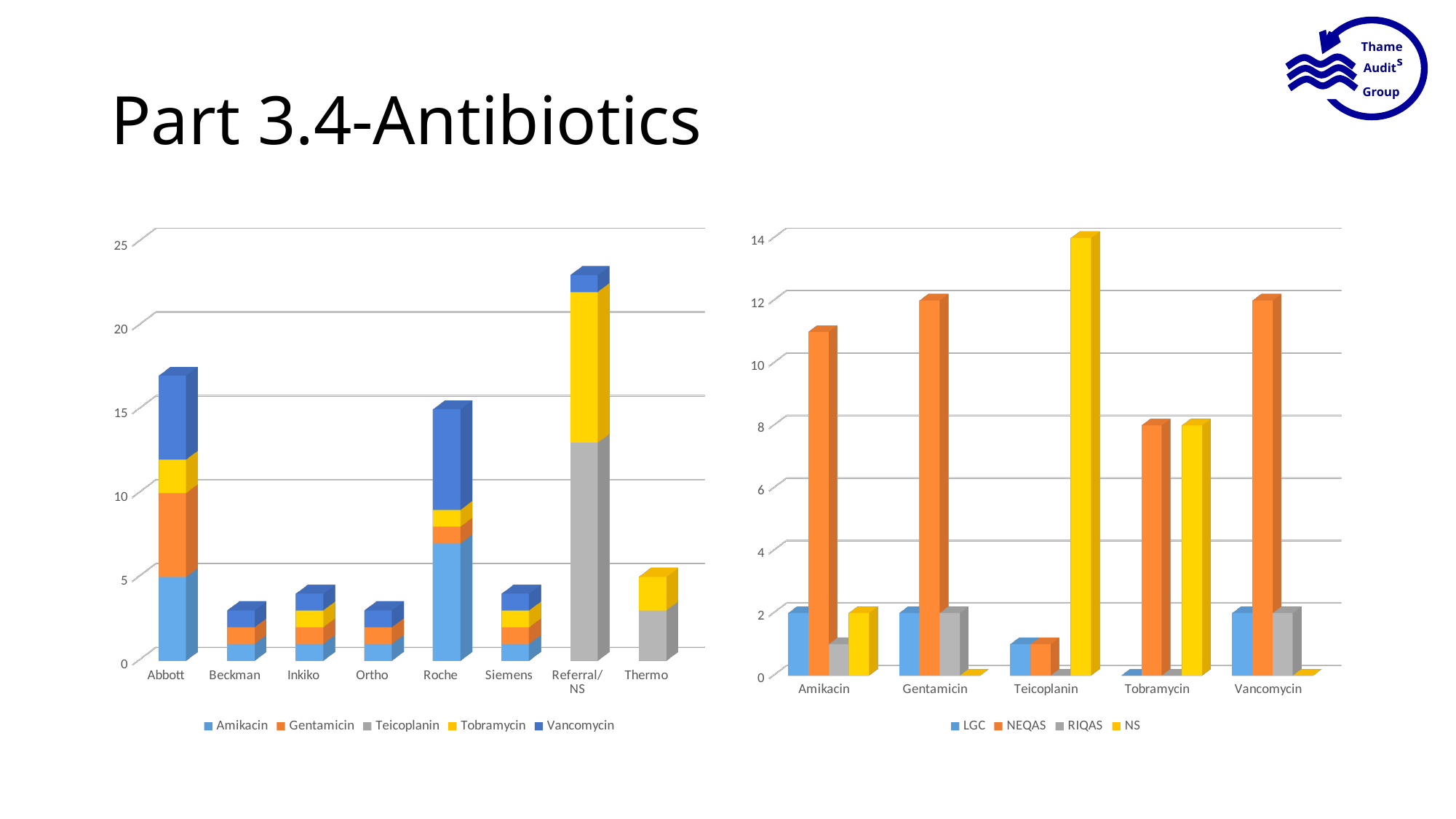
How many series does the legend of the left chart list? 5 In the right chart, is the NEQAS value for Amikacin greater or less than 10? greater How many series does the legend of the right chart list? 4 How many categories are shown on the x axis of the right chart? 5 In the right chart, which category has the highest NS bar? Teicoplanin In the right chart, what is the NEQAS value for Gentamicin? 12 In the right chart, what is the NS value for Teicoplanin? 14 In the right chart, which is larger: the NEQAS value for Vancomycin or the NEQAS value for Tobramycin? Vancomycin How many categories are shown on the x axis of the left chart? 8 What kind of chart is the left chart on the slide? Stacked bar chart In the left chart, which category has the tallest stacked bar? Referral/NS In the left chart, is the total for Referral/NS greater or less than 20? greater